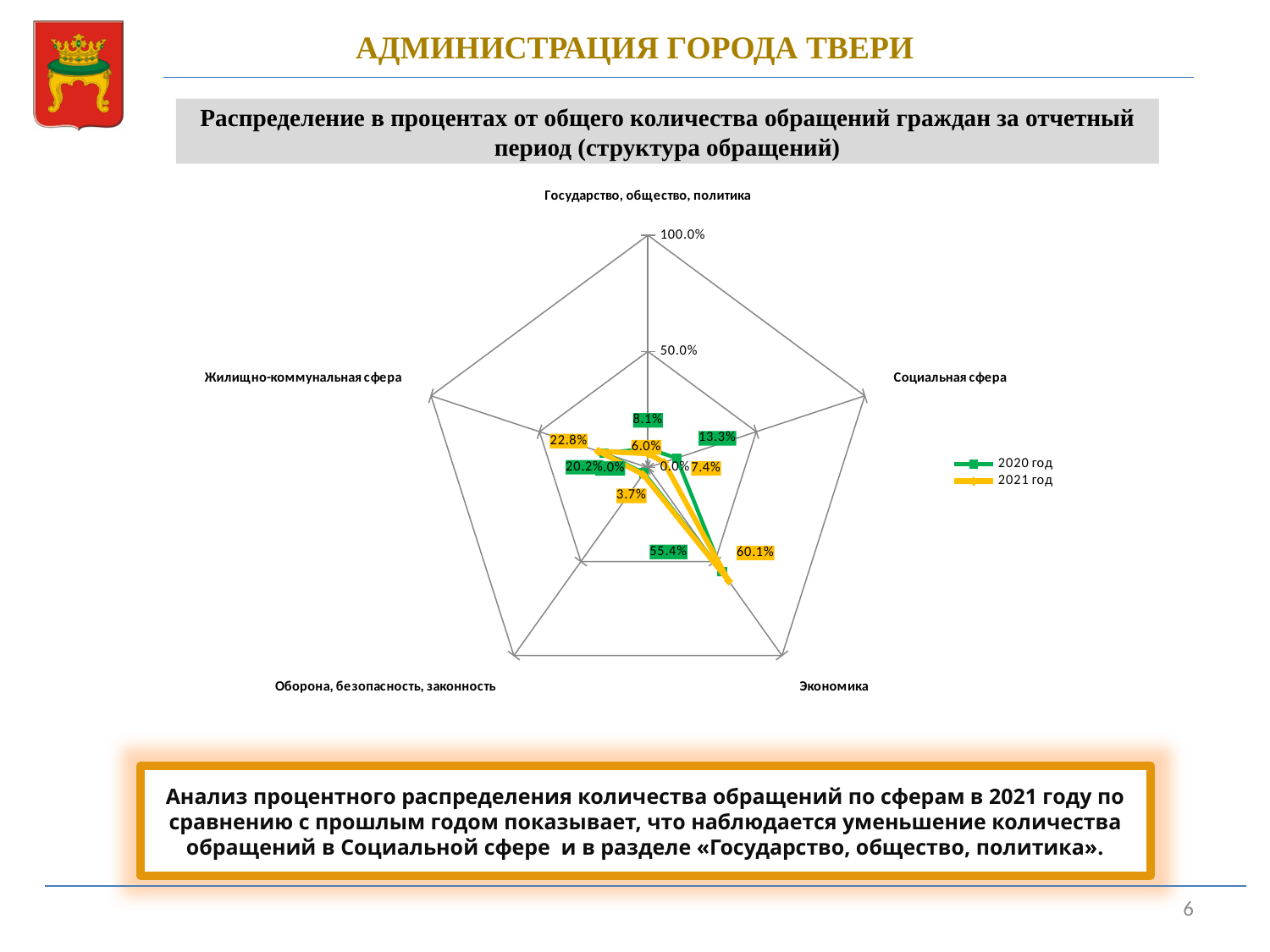
Which is larger for Социальная сфера: the 2020 год value or the 2021 год value? 2020 год What is the value for Государство, общество, политика in 2021 год? 6.0% What is the value for Жилищно-коммунальная сфера in 2021 год? 22.8% How many categories (axes) does the radar chart have? 5 What is the value for Социальная сфера in 2020 год? 13.3% Which category has the highest value for 2021 год? Экономика What is the difference between the 2021 год and 2020 год values for Экономика? 4.7% What is the value for Экономика in 2020 год? 55.4% How many series does the legend list? 2 What is the value for Экономика in 2021 год? 60.1% Which colour represents the 2021 год series? Yellow What kind of chart is shown on the slide? Radar chart